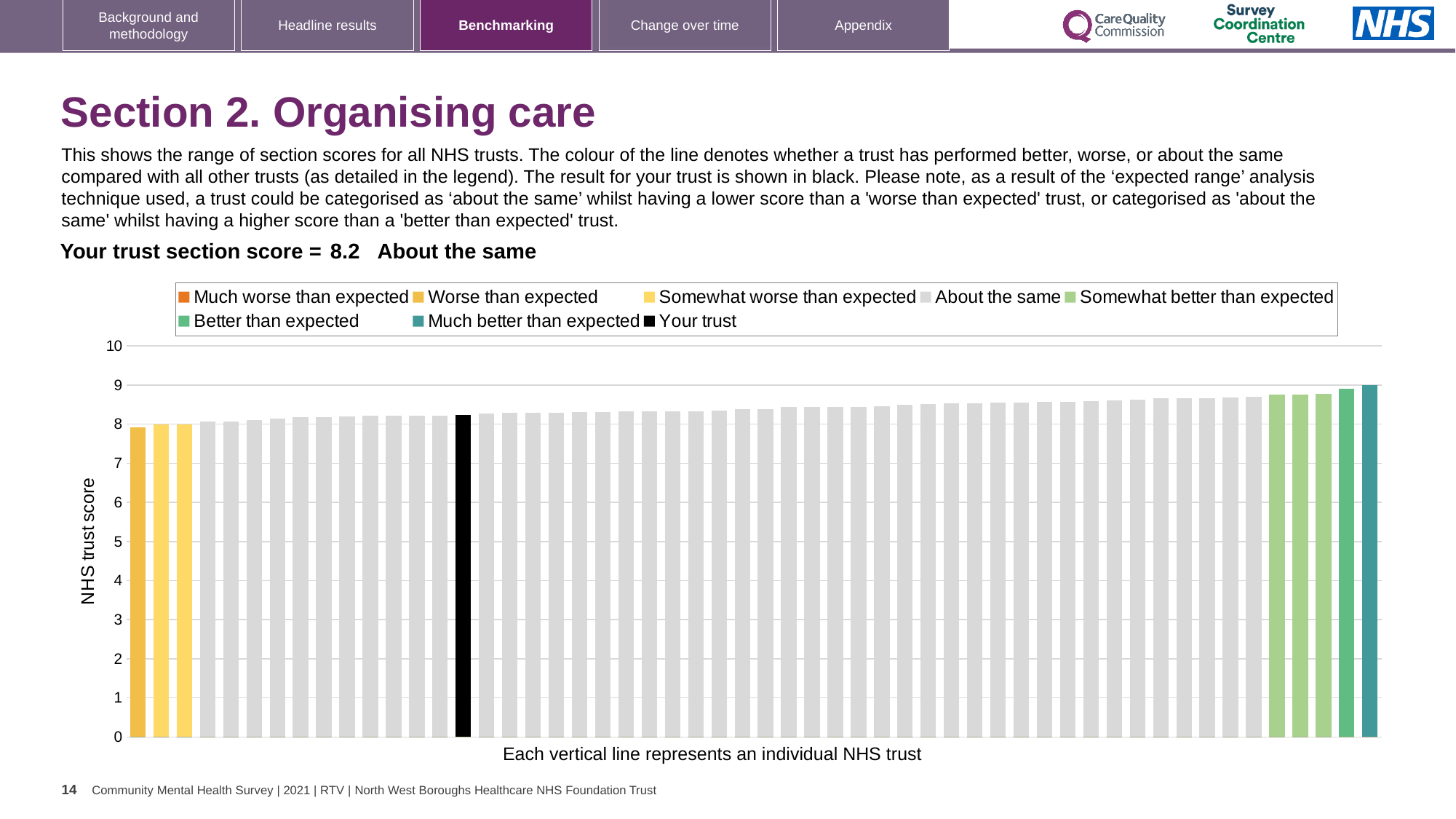
How many bars are coloured as 'Much better than expected' (teal)? 1 Is the value for the shortest bar greater or less than 9? less What is the title of the vertical axis? NHS trust score What colour is used for the bar representing your trust? Black What kind of chart is shown on the slide? Bar chart Do the bar values rise or fall from left to right along the x axis? Rise Which category is your trust placed in for this section? About the same What is the section score for your trust? 8.2 How many bars are coloured as 'Worse than expected' (yellow)? 1 Is the value for your trust (the black bar) greater or less than 8? greater Is the value for the tallest bar greater or less than 8? greater How many entries does the chart legend list? 8